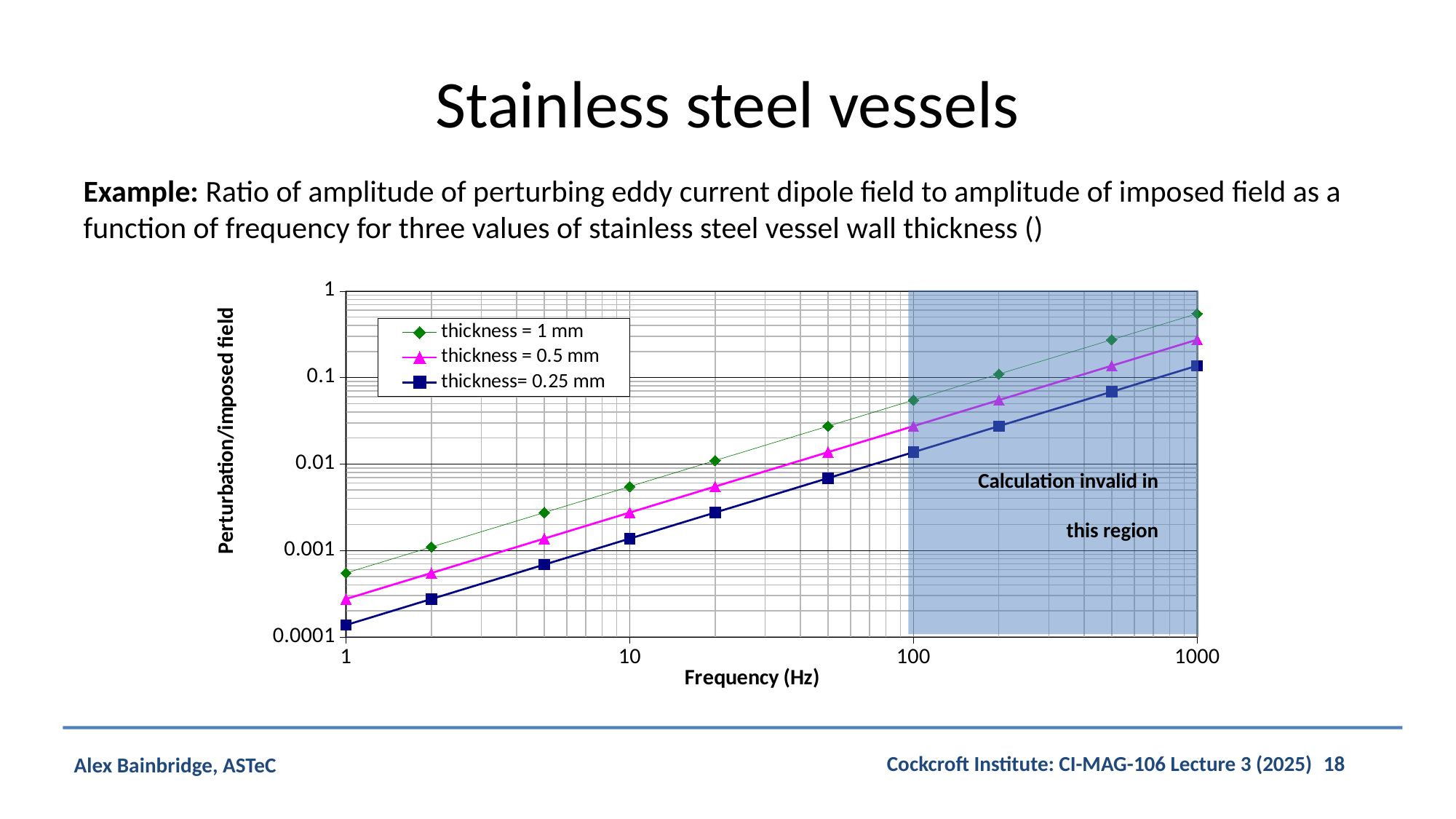
What is the label of the x axis? Frequency (Hz) Which series has the lowest perturbation/imposed field at 1 Hz? thickness= 0.25 mm At 100 Hz, which is larger: the value for thickness = 1 mm or the value for thickness= 0.25 mm? thickness = 1 mm How many data points are plotted for the thickness = 1 mm series? 10 What kind of chart is shown on the slide? line chart Do the values for thickness = 0.5 mm rise or fall as frequency increases? rise How many series does the legend list? 3 Which series has the highest perturbation/imposed field at 1000 Hz? thickness = 1 mm Is the value for thickness = 1 mm at 1000 Hz greater or less than 0.1? greater Is the value for thickness= 0.25 mm at 100 Hz greater or less than 0.01? greater What text is written in the shaded region of the chart? Calculation invalid in this region Is the value for thickness = 1 mm at 10 Hz greater or less than 0.01? less